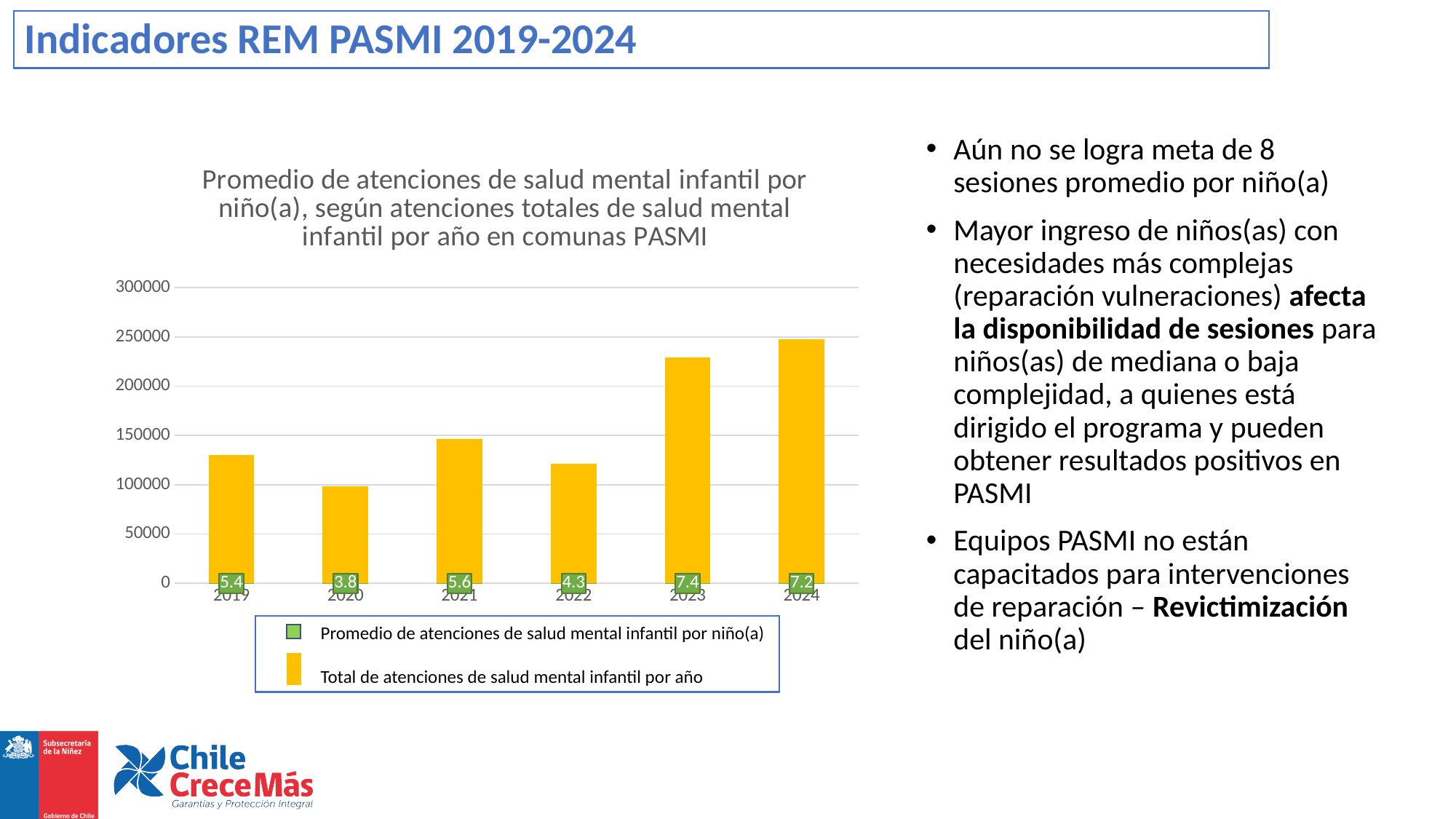
Is the value of 'Total de atenciones de salud mental infantil por año' for 2024 greater or less than 200000? greater Which year has the highest 'Promedio de atenciones de salud mental infantil por niño(a)'? 2023 What type of chart is used to show 'Total de atenciones de salud mental infantil por año'? Bar chart What is the value of 'Promedio de atenciones de salud mental infantil por niño(a)' for 2023? 7.4 What is the value of 'Promedio de atenciones de salud mental infantil por niño(a)' for 2019? 5.4 How many years are shown on the x axis of the chart? 6 What is the difference between the 'Promedio de atenciones de salud mental infantil por niño(a)' values for 2023 and 2020? 3.6 How many series does the chart legend list? 2 Which year has the lowest 'Promedio de atenciones de salud mental infantil por niño(a)'? 2020 Which year has a larger 'Promedio de atenciones de salud mental infantil por niño(a)', 2021 or 2022? 2021 What is the value of 'Promedio de atenciones de salud mental infantil por niño(a)' for 2020? 3.8